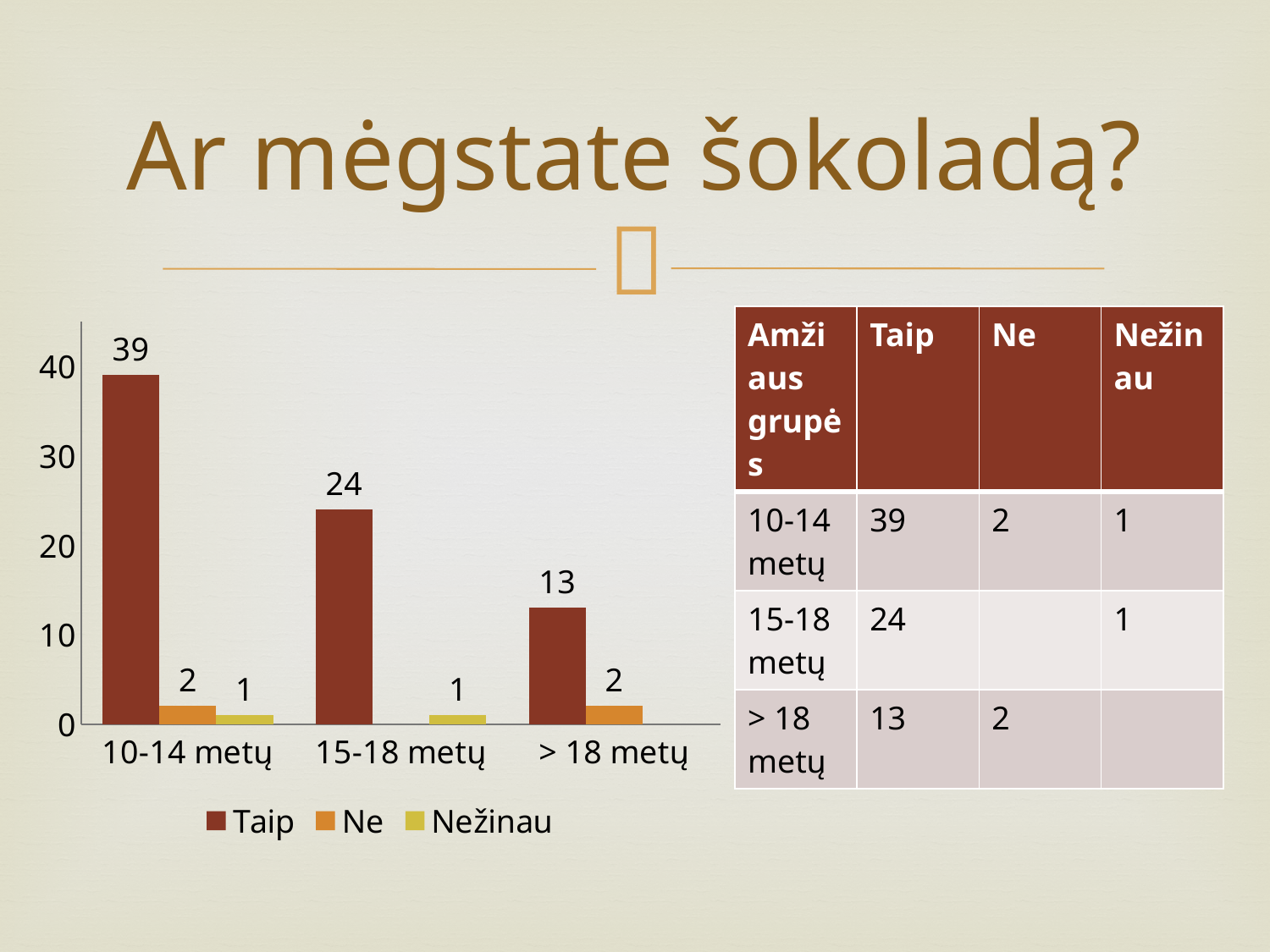
What is the value for Taip in the 10-14 metų group? 39 Which age group has the lowest Taip value? > 18 metų Which age group has the highest Taip value? 10-14 metų What is the value for Taip in the > 18 metų group? 13 How many series does the chart legend list? 3 What is the value for Nežinau in the 15-18 metų group? 1 What kind of chart is shown on the slide? Bar chart How many age groups are shown on the x axis of the chart? 3 What is the value for Ne in the > 18 metų group? 2 What is the difference between the Taip values for 10-14 metų and 15-18 metų? 15 What is the value for Taip in the 15-18 metų group? 24 Which is larger: the Taip value for 15-18 metų or the Taip value for > 18 metų? 15-18 metų